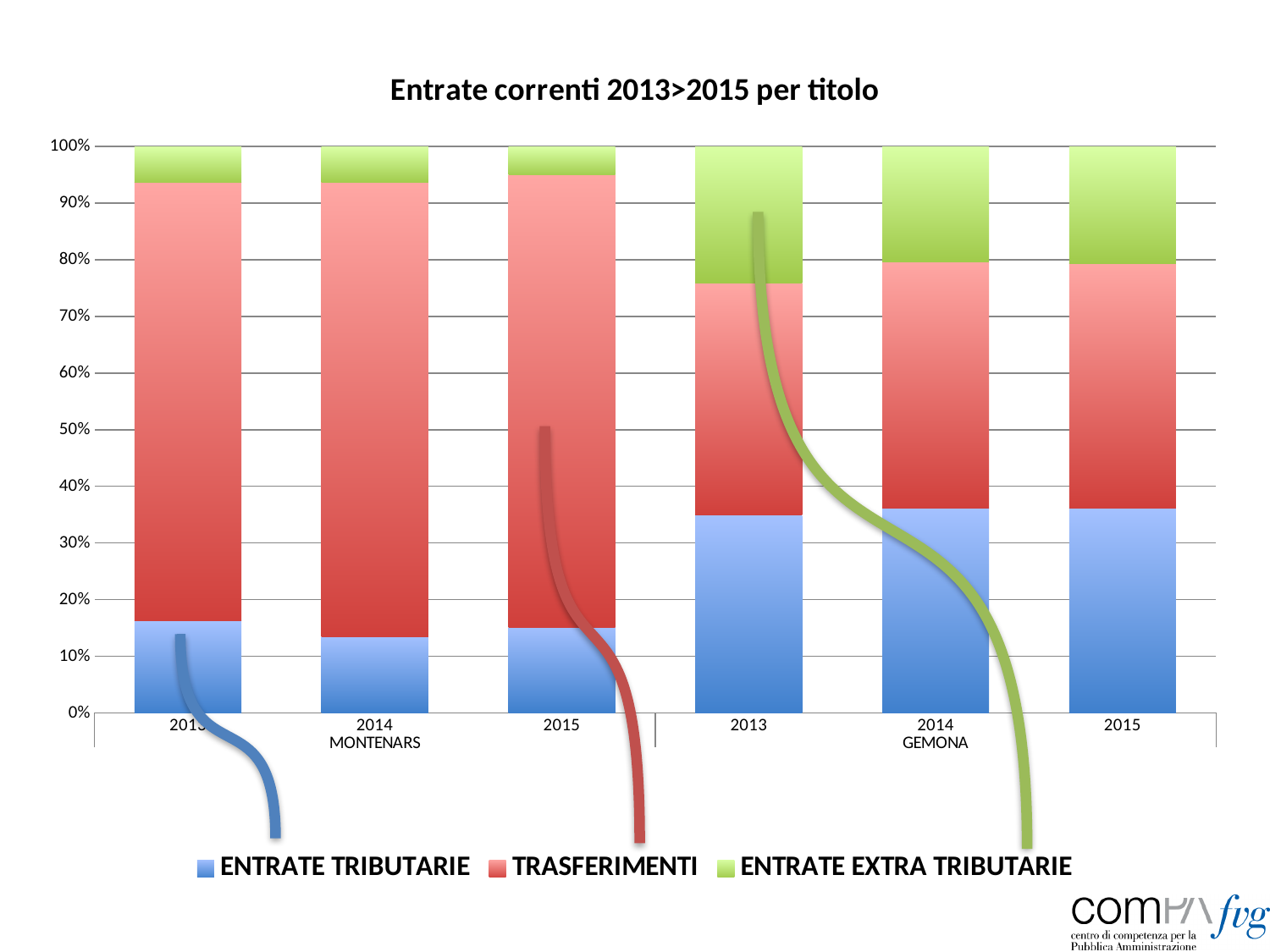
Which series takes the smallest share of the MONTENARS 2015 bar? ENTRATE EXTRA TRIBUTARIE Is the ENTRATE EXTRA TRIBUTARIE share for GEMONA 2013 greater or less than 20%? greater Is the ENTRATE EXTRA TRIBUTARIE share for MONTENARS 2014 greater or less than 10%? less How many bars are plotted in the chart? 6 What kind of chart is shown on the slide? Stacked bar chart Is the ENTRATE TRIBUTARIE share larger for GEMONA 2013 or for MONTENARS 2013? GEMONA 2013 Which series takes the largest share of the MONTENARS 2014 bar? TRASFERIMENTI Is the ENTRATE TRIBUTARIE share for GEMONA 2013 greater or less than 30%? greater How many series does the legend list? 3 Which colour represents TRASFERIMENTI in the legend? Red What is the title of the chart? Entrate correnti 2013>2015 per titolo